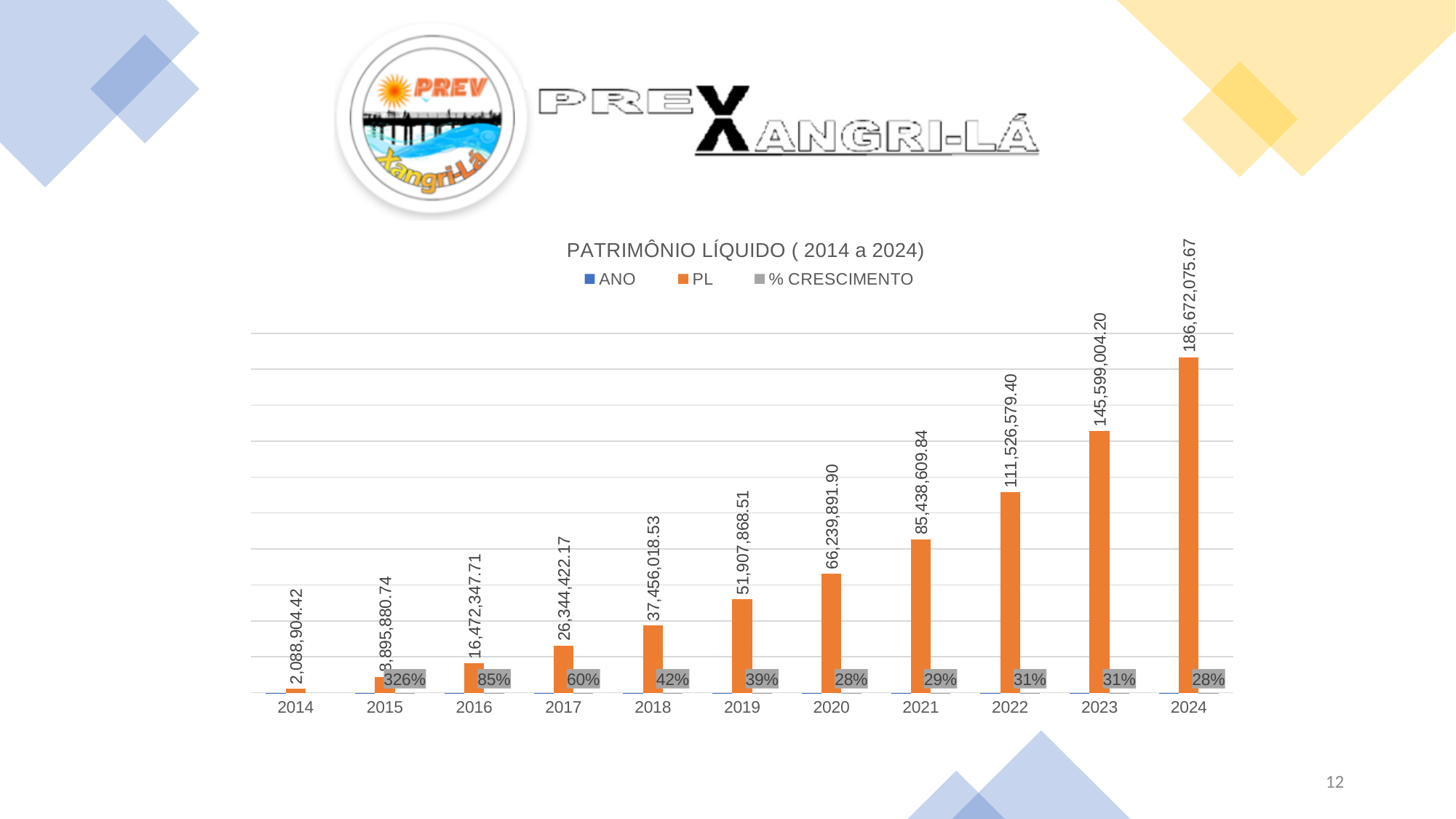
What is the % CRESCIMENTO shown for 2022? 31% What kind of chart is shown on the slide? Bar chart How many series does the legend list? 3 What is the PL value for 2014? 2,088,904.42 What is the % CRESCIMENTO shown for 2015? 326% Which year has the lowest PL value? 2014 Which year has the larger PL value, 2019 or 2021? 2021 How many years are shown on the x axis? 11 Which year has the highest PL value? 2024 What is the difference between the PL values for 2024 and 2023? 41,073,071.47 Do the PL values rise or fall from 2014 to 2024? Rise What is the PL value for 2024? 186,672,075.67